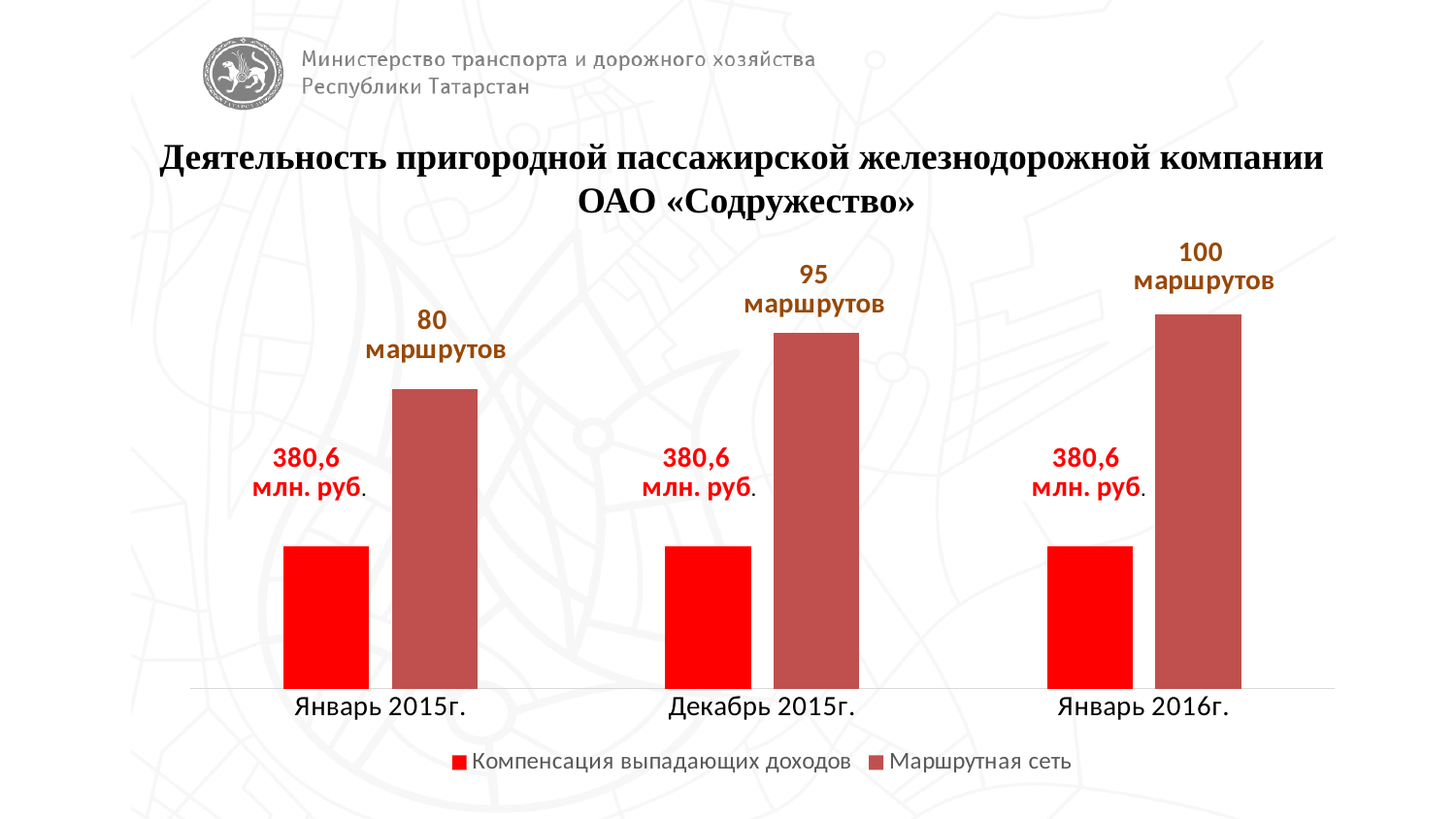
Which category has the highest value for the Маршрутная сеть series? Январь 2016г. What is the value of the Маршрутная сеть series for Январь 2015г.? 80 маршрутов How many categories are shown on the x axis of the chart? 3 By how many маршрутов does the Маршрутная сеть value for Январь 2016г. exceed that for Январь 2015г.? 20 What kind of chart is shown on the slide? bar chart Which category has the lowest value for the Маршрутная сеть series? Январь 2015г. What is the value of the Маршрутная сеть series for Декабрь 2015г.? 95 маршрутов What is the value of the Маршрутная сеть series for Январь 2016г.? 100 маршрутов How many series does the chart legend list? 2 Does the Маршрутная сеть series rise or fall from Январь 2015г. to Январь 2016г.? rise What is the value of Компенсация выпадающих доходов for Декабрь 2015г.? 380,6 млн. руб. Which series is shown in the darker red colour in the legend? Маршрутная сеть